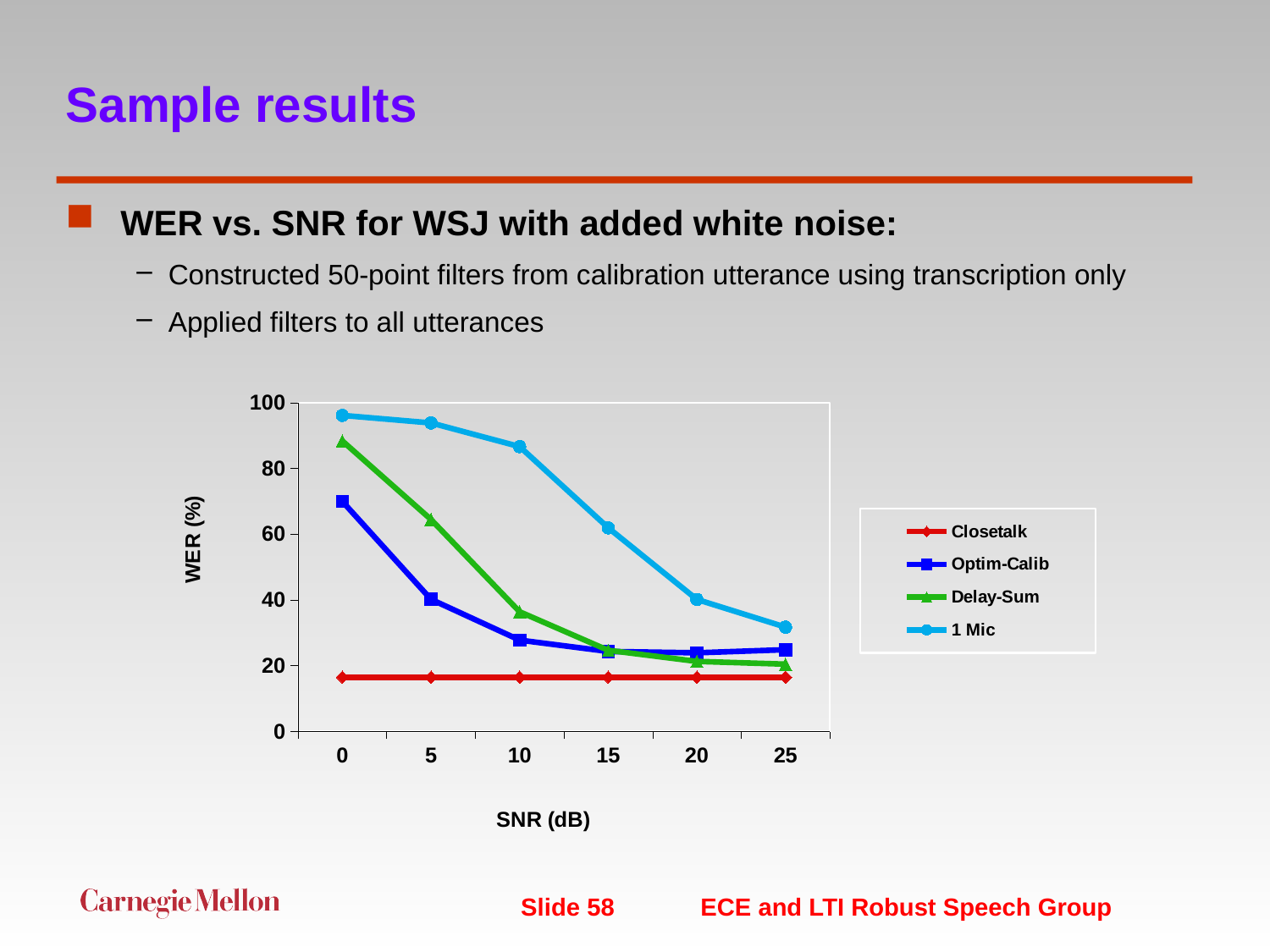
Is the WER for Closetalk at 25 dB SNR greater or less than 20? less How many SNR values are plotted along the x axis? 6 What kind of chart is shown on the slide? line chart Is the WER for Optim-Calib at 5 dB SNR greater or less than 60? less At 5 dB SNR, which has the higher WER: Delay-Sum or Optim-Calib? Delay-Sum Which series has the lowest WER across all SNR values? Closetalk Does the WER for 1 Mic rise or fall as SNR increases? falls How many series does the legend list? 4 Is the WER for Delay-Sum at 10 dB SNR greater or less than 60? less At 20 dB SNR, which series has the highest WER? 1 Mic What is the label on the y axis of the chart? WER (%)